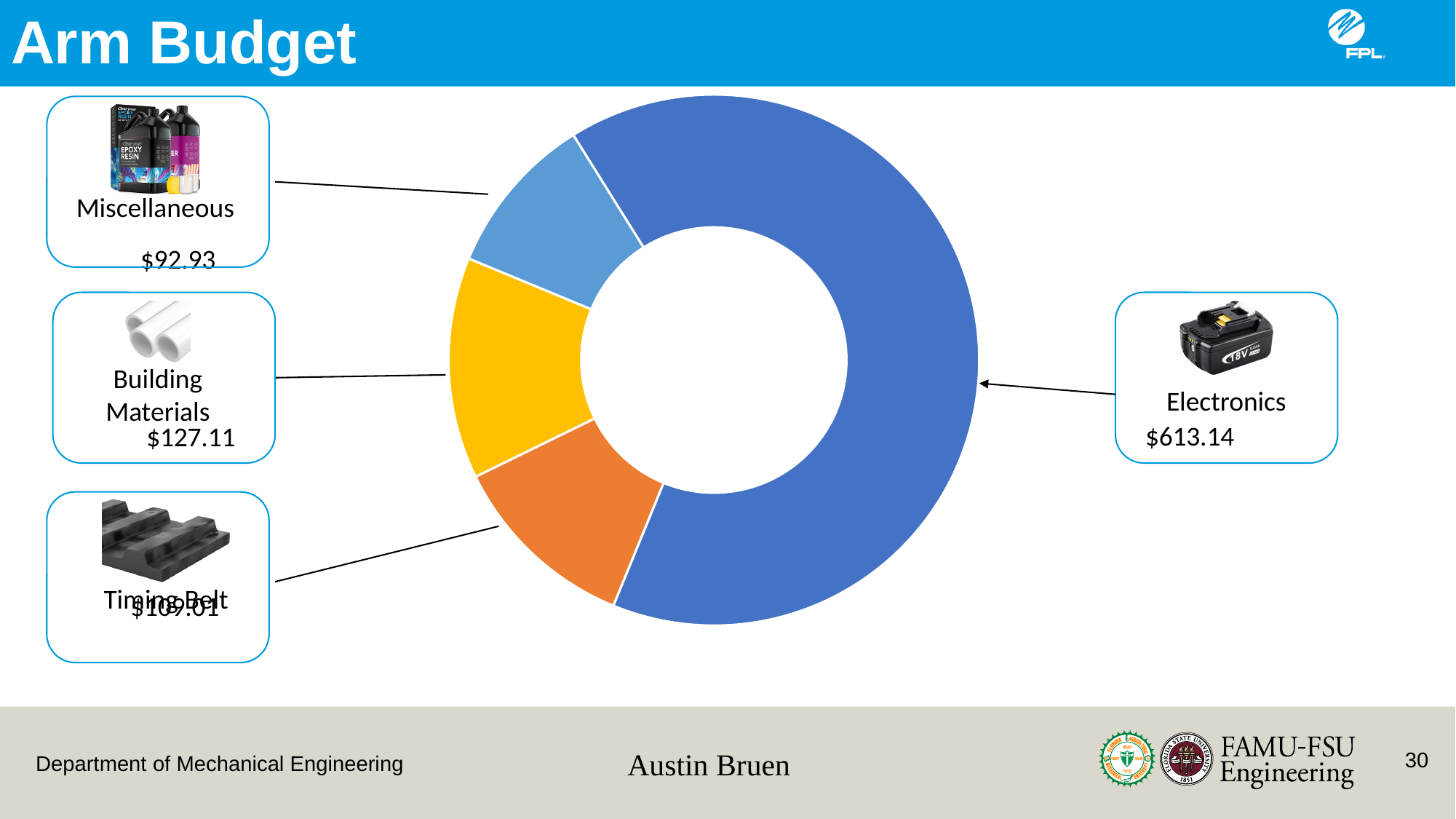
Which category has the smallest value in the chart? Miscellaneous What kind of chart is shown on the slide? donut (pie) chart What is the value shown for Miscellaneous? $92.93 What is the value shown for Building Materials? $127.11 Which is larger, Building Materials or Miscellaneous? Building Materials What colour is the Electronics segment of the chart? blue What is the difference between the Electronics value and the Building Materials value? $486.03 Which category has the largest share of the arm budget? Electronics How many categories are shown in the chart? 4 What is the difference between the Building Materials value and the Miscellaneous value? $34.18 What is the value shown for Electronics? $613.14 What is the title of the slide containing the chart? Arm Budget